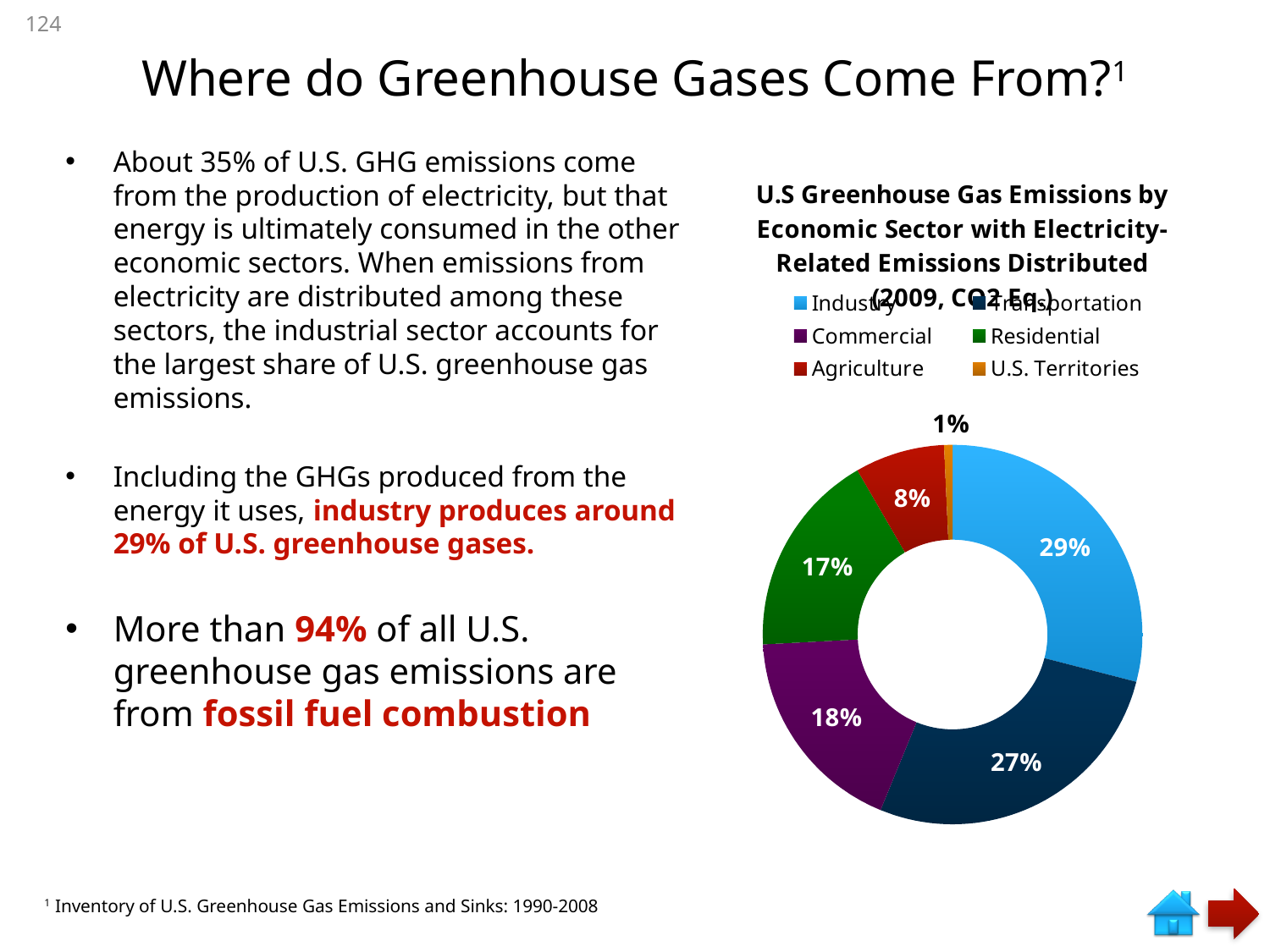
What percentage is shown for Commercial in the chart? 18% What percentage is shown for Transportation in the chart? 27% What percentage is shown for Residential in the chart? 17% Which sector has the smallest share in the chart? U.S. Territories What type of chart is used on the slide? doughnut chart What percentage is shown for Agriculture in the chart? 8% What share of U.S. greenhouse gas emissions does the chart attribute to Industry? 29% Which sector has the largest share in the chart? Industry What colour represents Commercial in the chart? purple How many sectors are shown in the chart? 6 What is the difference in percentage points between the Industry and Transportation shares? 2 Which has a larger share, Residential or Agriculture? Residential